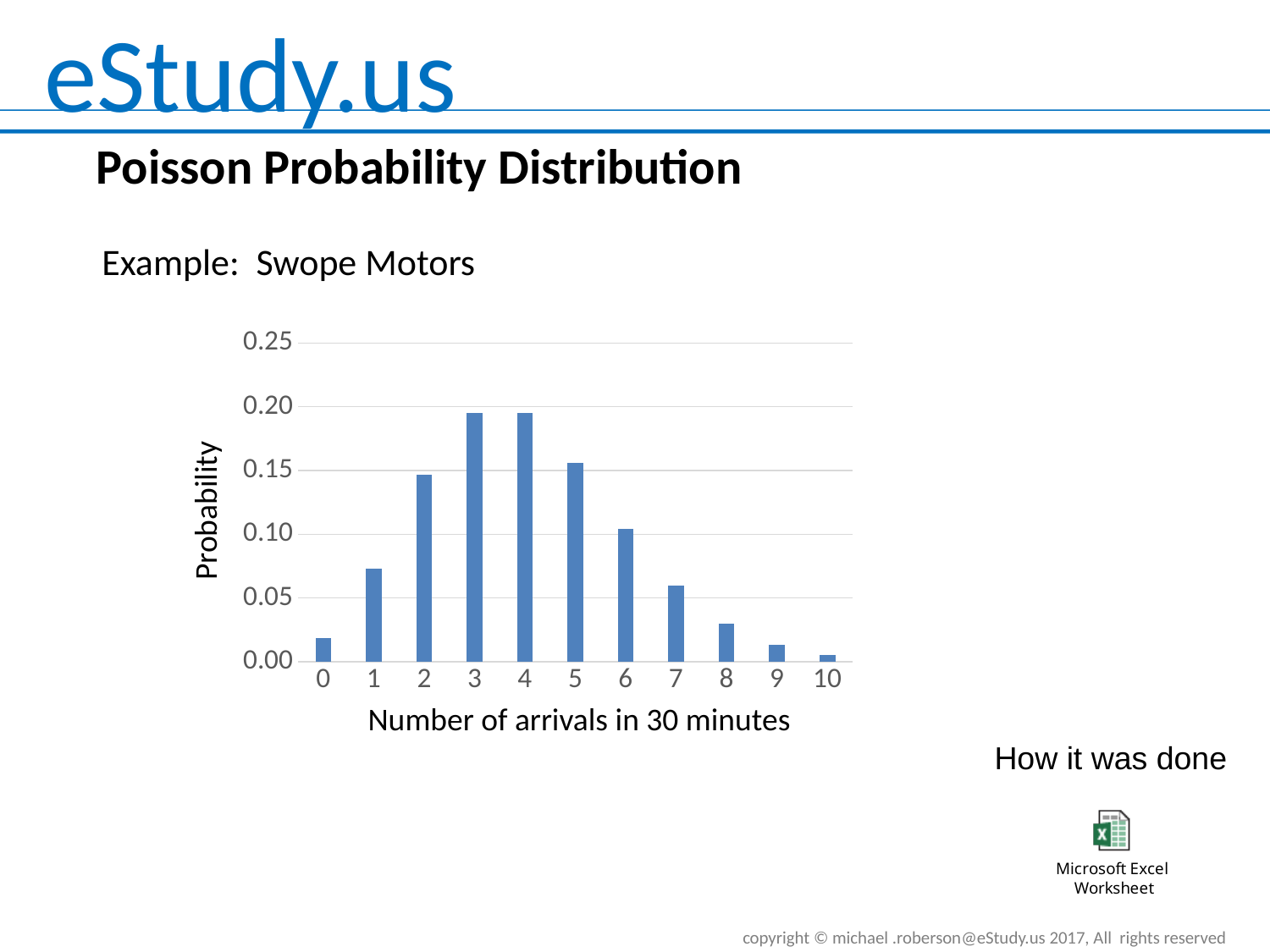
How many categories (numbers of arrivals) are plotted on the x axis? 11 Is the probability for 2 arrivals greater or less than 0.10? greater Is the probability for 8 arrivals greater or less than 0.05? less Which has the larger probability, 1 arrival or 7 arrivals? 1 arrival What kind of chart is shown on the slide? bar chart Which number of arrivals has the lowest probability? 10 Is the probability for 0 arrivals greater or less than 0.05? less How do the probabilities change as the number of arrivals increases from 0 to 10? They rise to a peak around 3 and 4, then fall Which has the larger probability, 2 arrivals or 6 arrivals? 2 arrivals What is the title of the x axis? Number of arrivals in 30 minutes